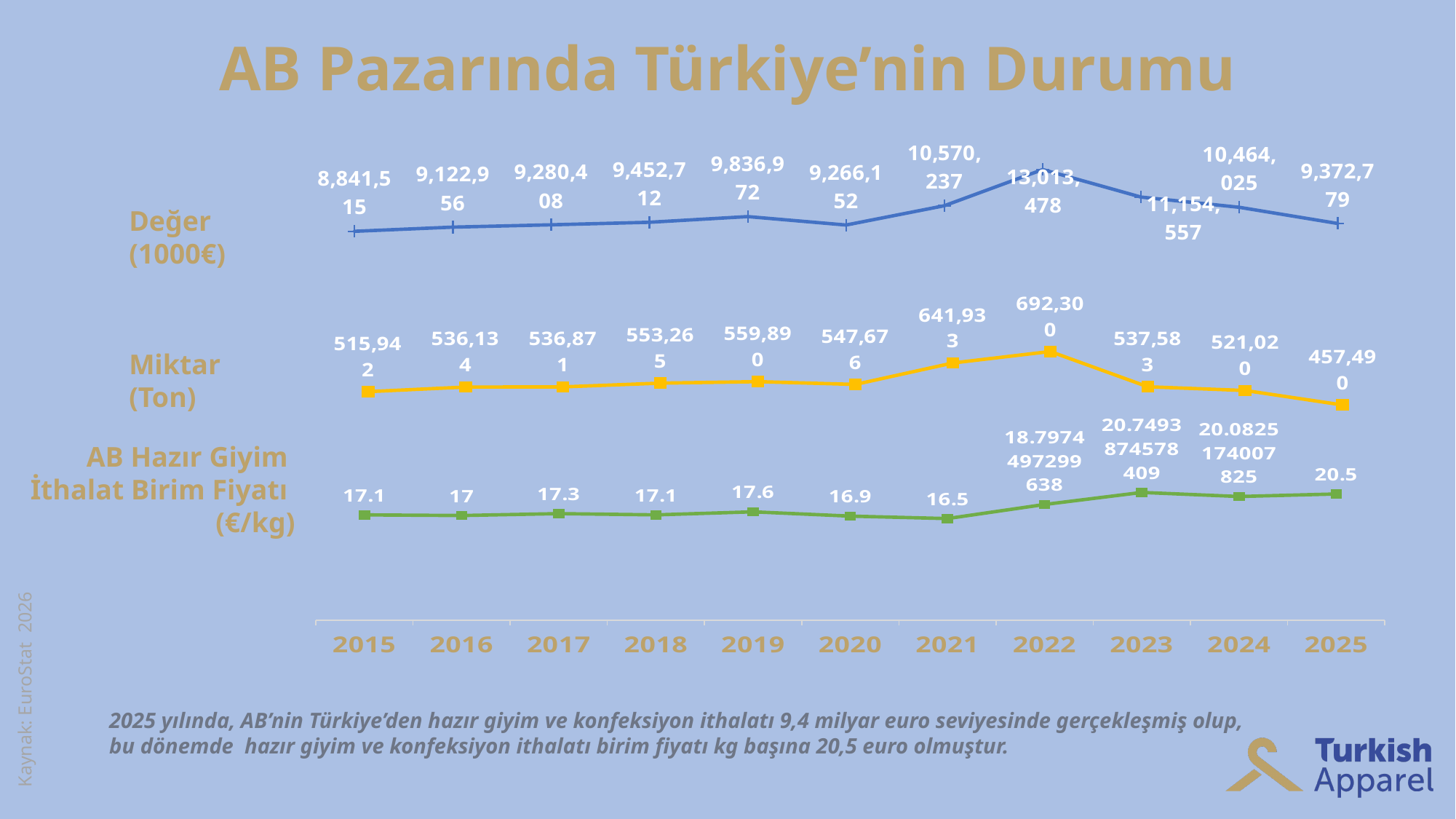
What kind of chart is shown on the slide? Line chart What is the AB Hazır Giyim İthalat Birim Fiyatı (€/kg) value for 2019? 17.6 What is the difference between the AB Hazır Giyim İthalat Birim Fiyatı (€/kg) values for 2025 and 2015? 3.4 How many years are shown on the x axis? 11 What is the Miktar (Ton) value for 2025? 457,490 What is the difference between the Miktar (Ton) values for 2022 and 2021? 50,367 Which year has the larger Değer (1000€) value, 2019 or 2020? 2019 In which year is the Miktar (Ton) series lowest? 2025 In which year is the Değer (1000€) series highest? 2022 What is the Değer (1000€) value for 2022? 13,013,478 How many data series are plotted on the chart? 3 In which year is the AB Hazır Giyim İthalat Birim Fiyatı (€/kg) lowest? 2021